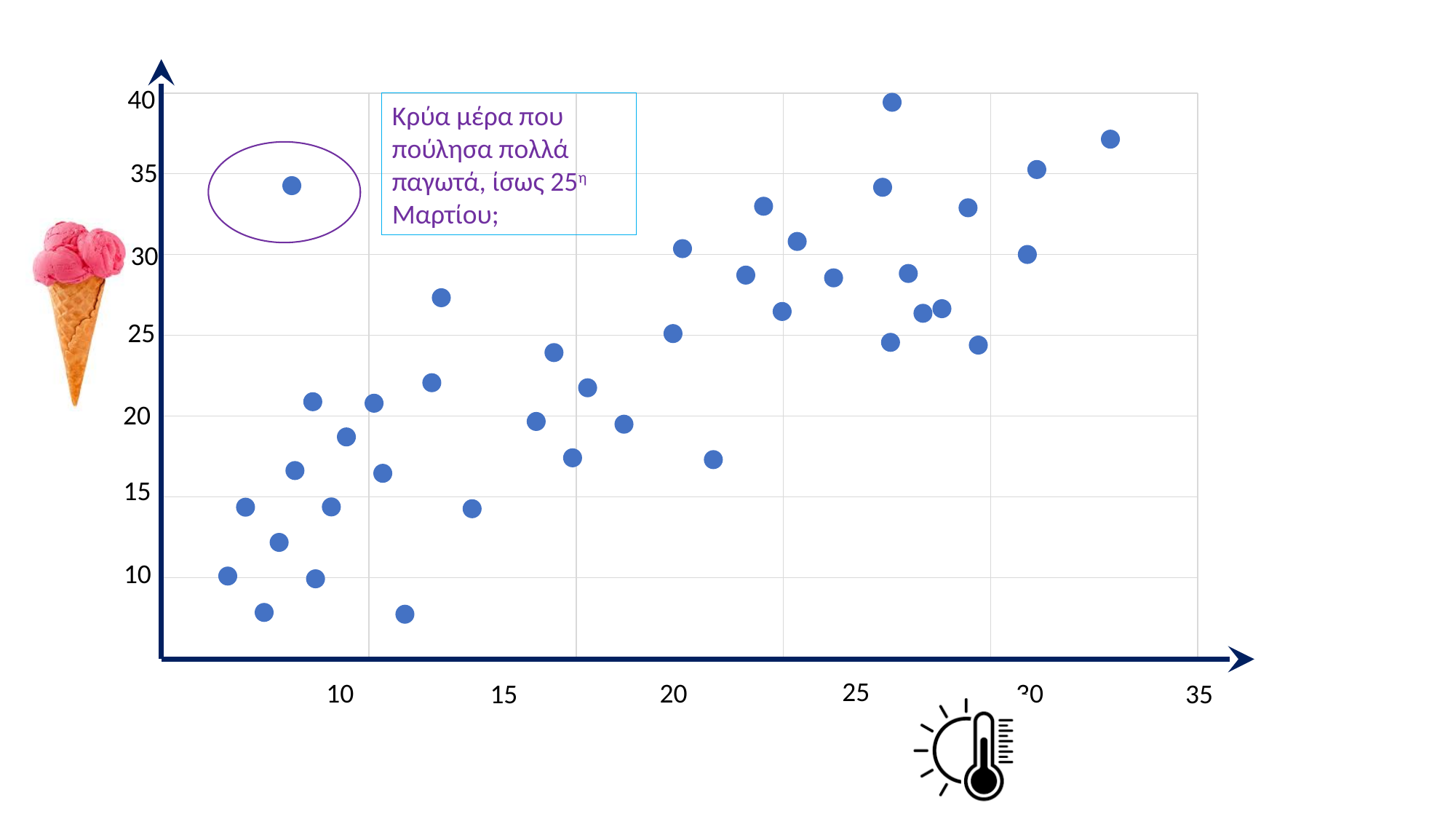
Is the y value of the circled point greater or less than 30? greater What is the highest tick label shown on the x axis? 35 What is the highest tick label shown on the y axis? 40 Which has the higher y value: the circled point or the point at about x = 13? the circled point Do the plotted values generally rise or fall as you move right along the x axis? rise Is the y value of the highest point on the chart greater or less than 35? greater Is the y value of the lowest point on the chart greater or less than 10? less What kind of chart is shown on the slide? scatter plot